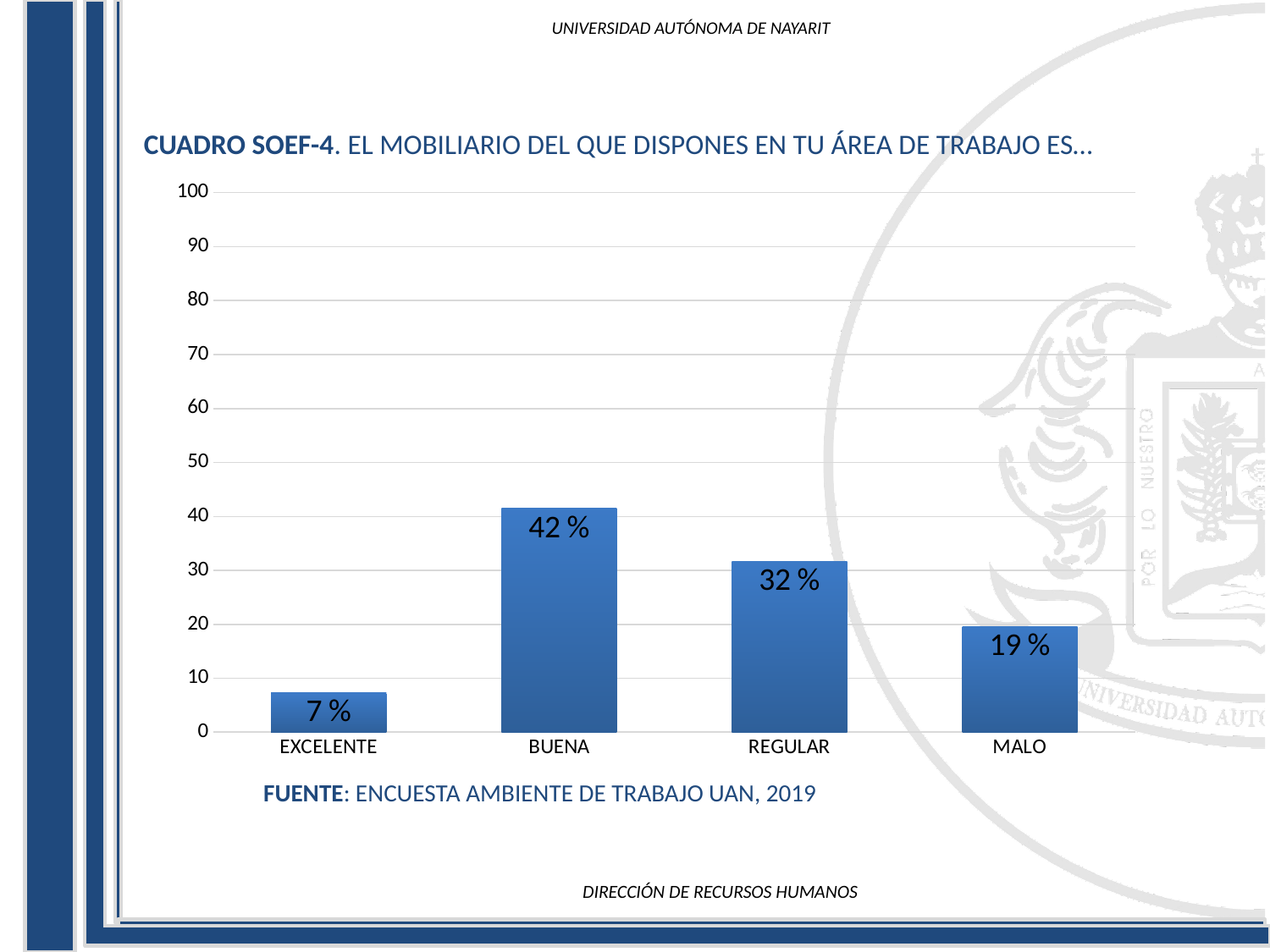
Which category has the highest value? BUENA Which category has the lowest value? EXCELENTE What is the value for EXCELENTE? 7 % What is the value for BUENA? 42 % What is the difference between the values for BUENA and REGULAR? 10 % Which is larger, the value for REGULAR or the value for MALO? REGULAR What kind of chart is shown on the slide? bar chart What is the highest value shown on the y axis? 100 What is the source cited below the chart? ENCUESTA AMBIENTE DE TRABAJO UAN, 2019 How many categories are shown on the x axis? 4 Is the value for REGULAR greater or less than 40? less What is the value for MALO? 19 %